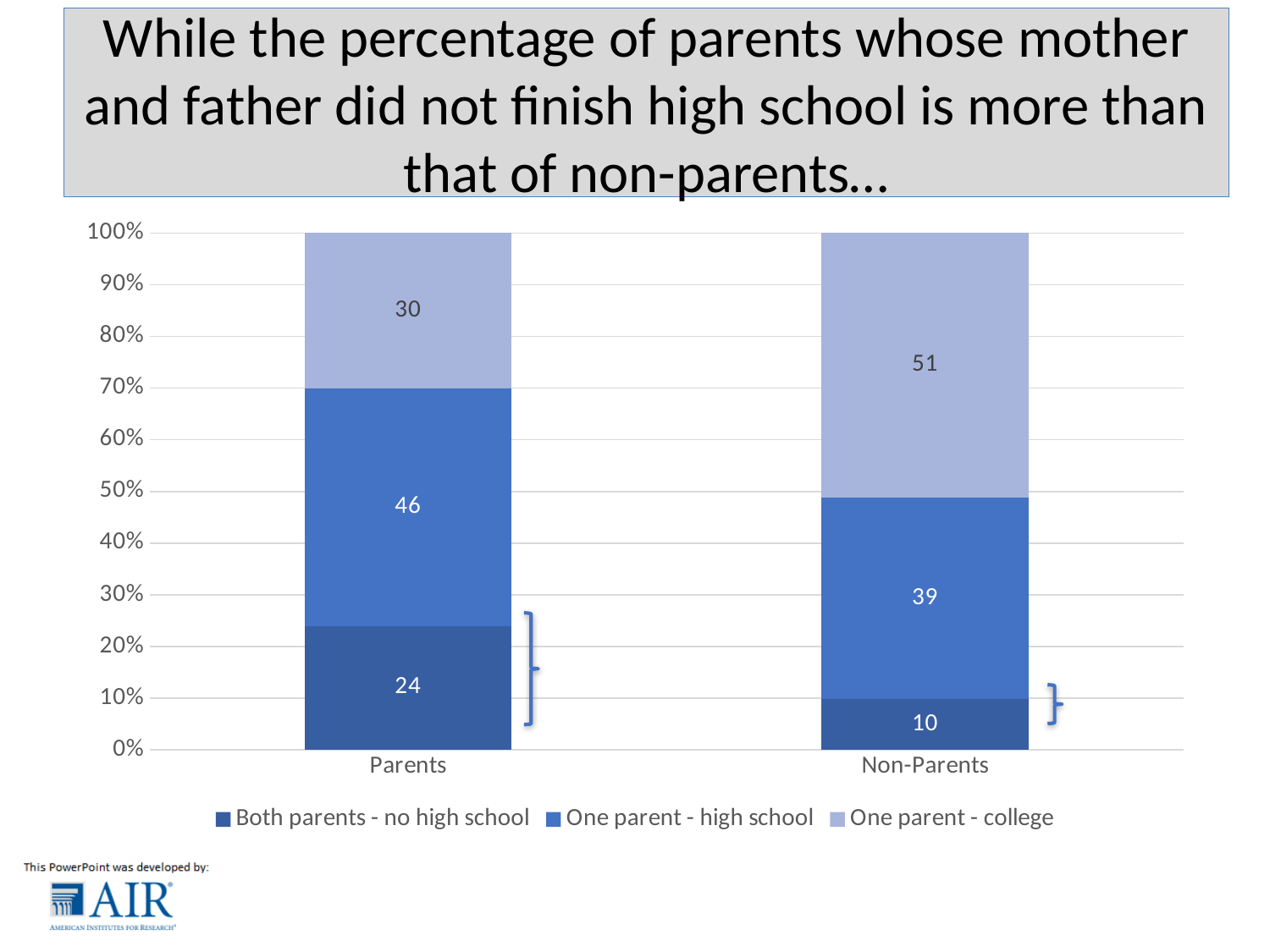
What is the difference between the 'One parent - college' values for Non-Parents and Parents? 21 How many categories are shown on the x axis? 2 Which series has the largest value within the Parents bar? One parent - high school Which category has the higher value for 'Both parents - no high school', Parents or Non-Parents? Parents What is the value for 'Both parents - no high school' in the Parents bar? 24 What is the value for 'Both parents - no high school' in the Non-Parents bar? 10 How many series does the legend list? 3 What kind of chart is shown on the slide? Stacked bar chart What is the value for 'One parent - high school' in the Parents bar? 46 What is the difference between the 'Both parents - no high school' values for Parents and Non-Parents? 14 What is the value for 'One parent - college' in the Non-Parents bar? 51 Which series has the smallest value within the Non-Parents bar? Both parents - no high school